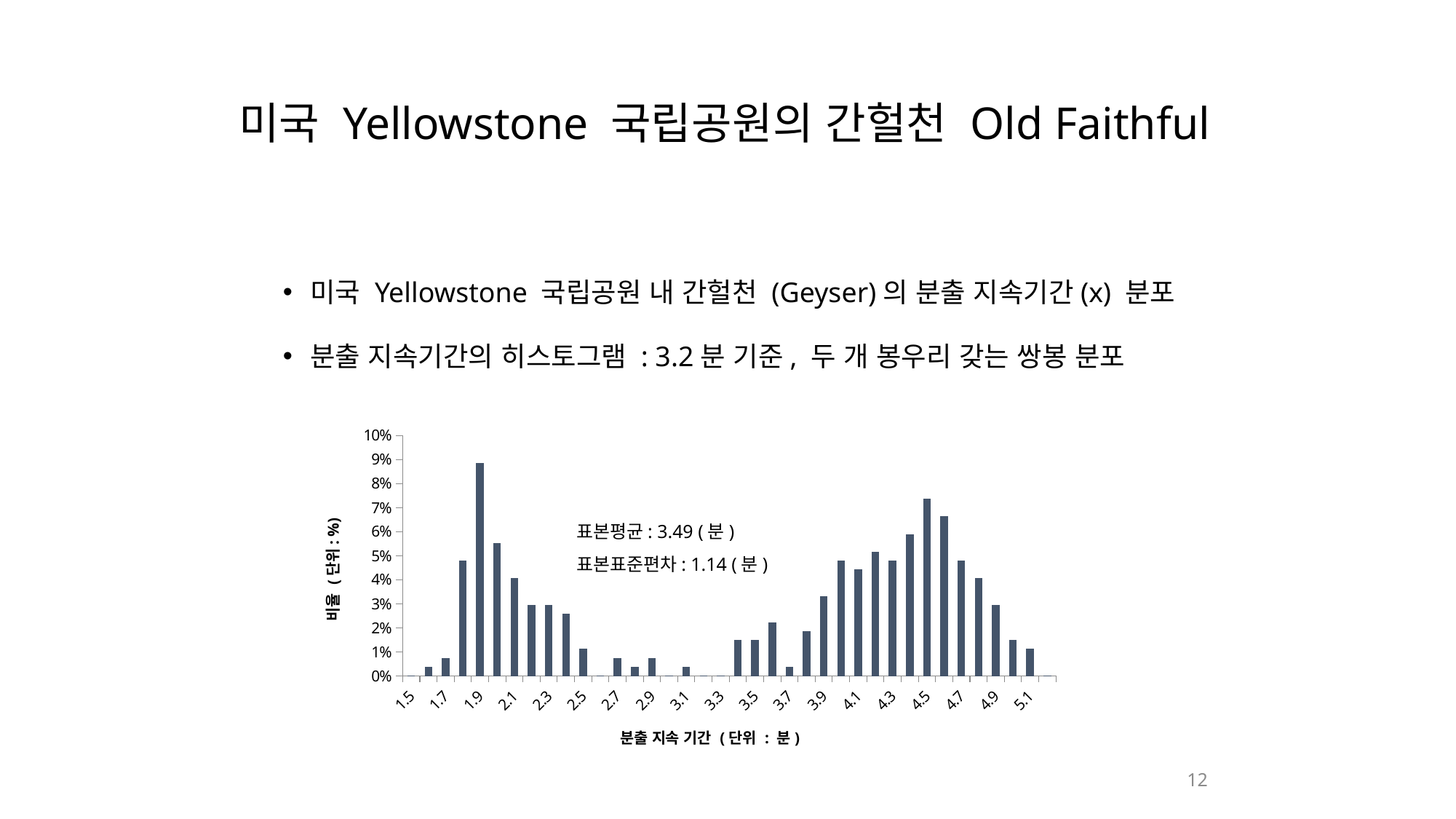
Do the values rise or fall from 1.9 to 2.5 along the x axis? fall Is the value for 4.5 greater or less than 7%? greater What kind of chart is shown on the slide? bar chart Is the value for 1.9 greater or less than 8%? greater Which is larger, the value for 1.9 or the value for 4.5? 1.9 Which x-axis category has the highest bar? 1.9 Is the value for 5.1 greater or less than 2%? less What sample mean (표본평균) is annotated on the chart? 3.49 (분) Which is larger, the value for 2.5 or the value for 4.9? 4.9 What sample standard deviation (표본표준편차) is annotated on the chart? 1.14 (분)